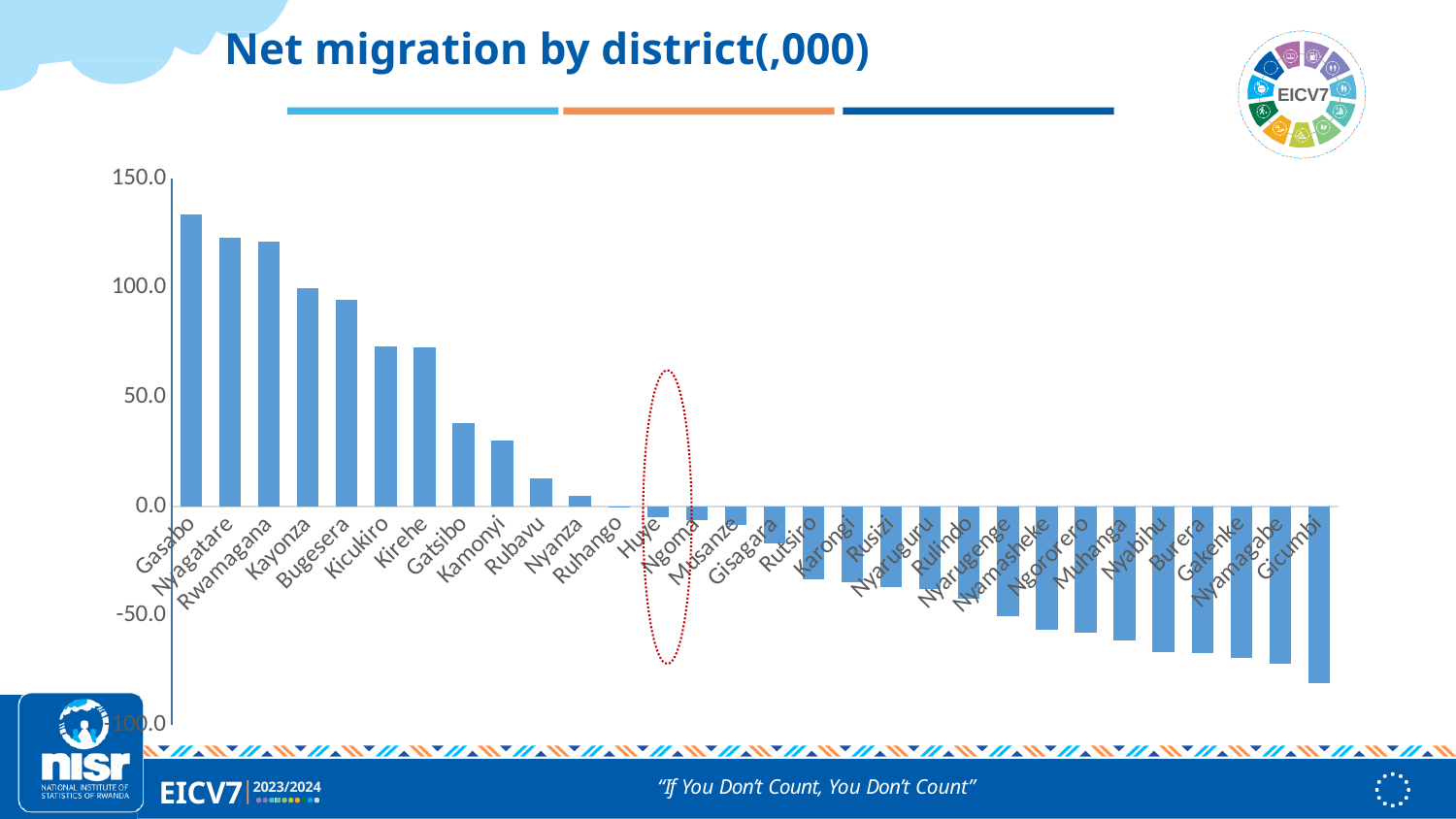
Is the value for Kicukiro greater or less than 50.0? greater Is the value for Gatsibo greater or less than 50.0? less Is the value for Gasabo greater or less than 100.0? greater Which district has the highest net migration? Gasabo How many districts are shown on the x axis? 30 Which has the larger net migration, Gasabo or Nyagatare? Gasabo Do the values rise or fall moving from left to right along the x axis? fall What kind of chart is shown on the slide? bar chart Which district has the lowest net migration? Gicumbi What is the title of the chart? Net migration by district(,000)